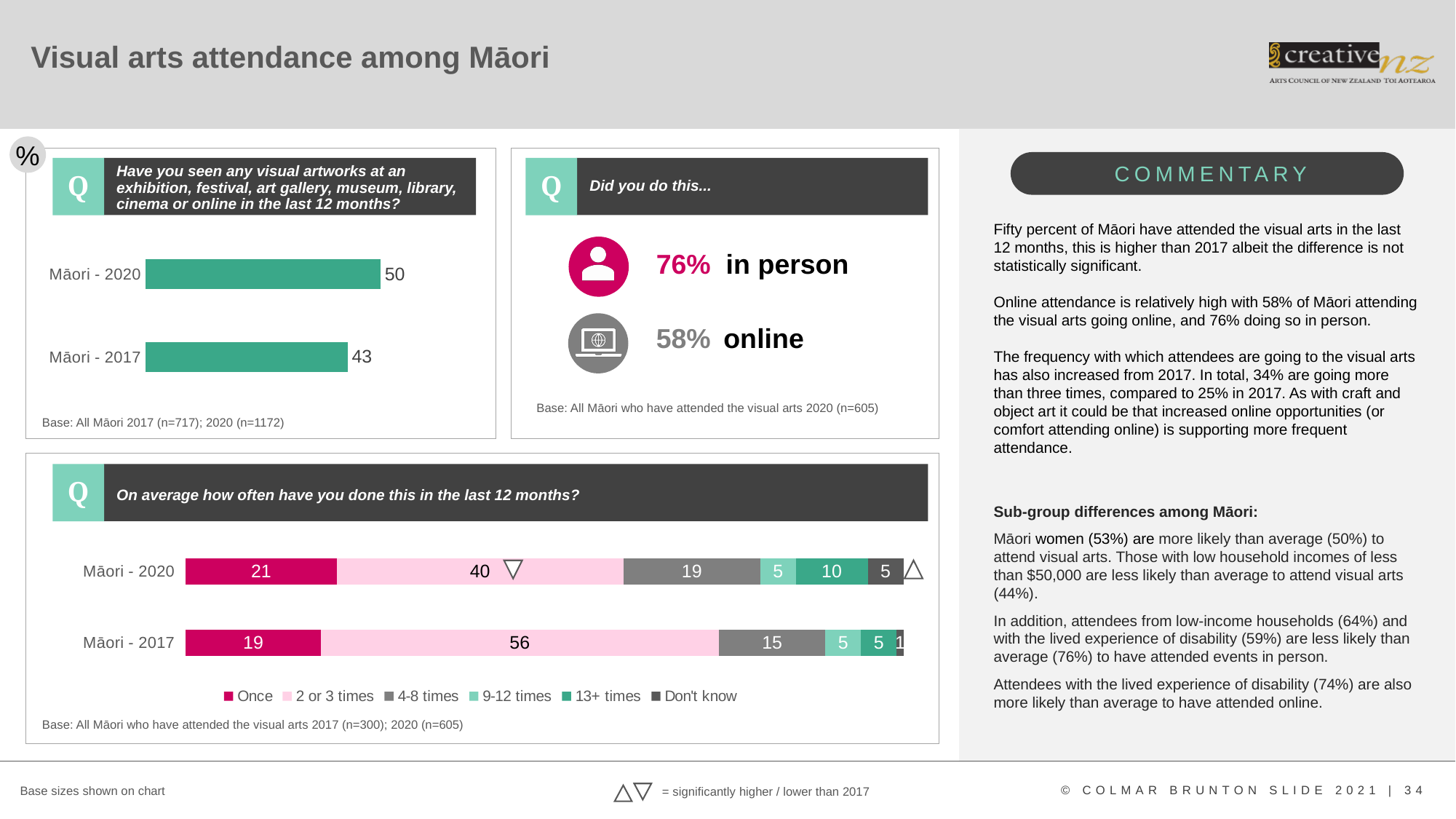
In the bottom chart on how often this was done in the last 12 months, what is the value for '2 or 3 times' for Māori - 2020? 40 In the bottom chart on how often this was done in the last 12 months, which category has the smallest value for Māori - 2017? Don't know In the bottom chart on how often this was done in the last 12 months, what is the value for '13+ times' for Māori - 2017? 5 In the bottom chart on how often this was done in the last 12 months, what is the difference between the '2 or 3 times' values for Māori - 2017 and Māori - 2020? 16 In the bottom chart on how often this was done in the last 12 months, how many series does the legend list? 6 In the top-left chart on visual artworks seen in the last 12 months, what is the value for Māori - 2020? 50 In the top-left chart on visual artworks seen in the last 12 months, what is the value for Māori - 2017? 43 In the bottom chart on how often this was done in the last 12 months, which category has the largest value for Māori - 2017? 2 or 3 times In the top-left chart on visual artworks seen in the last 12 months, which year has the higher value? Māori - 2020 What kind of chart is the top-left chart on visual artworks seen in the last 12 months? Bar chart In the top-left chart on visual artworks seen in the last 12 months, what is the difference between the Māori - 2020 and Māori - 2017 values? 7 In the bottom chart on how often this was done in the last 12 months, what is the total of the Māori - 2020 stacked bar? 100